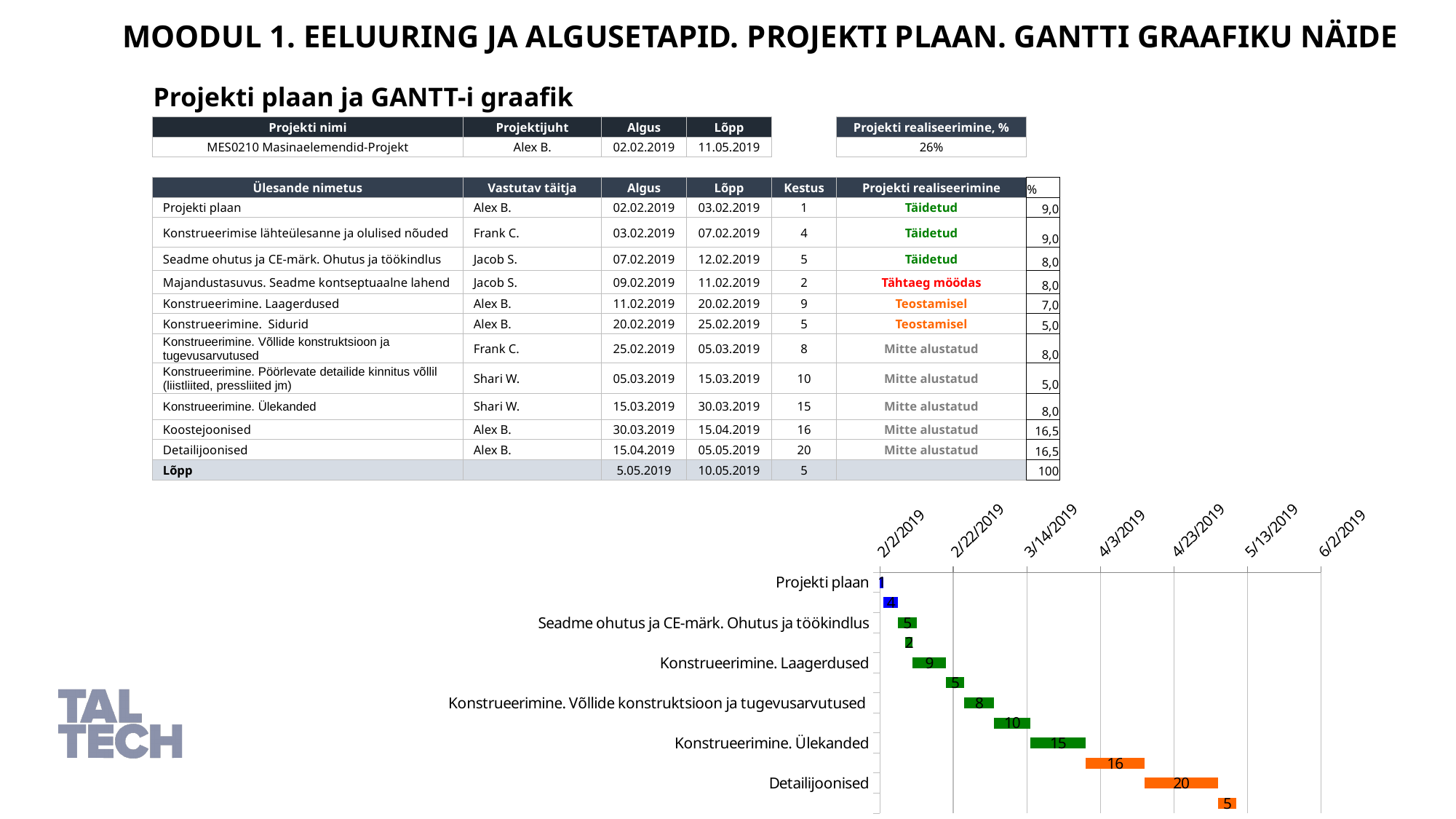
In the Gantt chart, what is the value labelled on the bar for Seadme ohutus ja CE-märk. Ohutus ja töökindlus? 5 In the Gantt chart, which labelled task has the shortest bar? Projekti plaan In the Gantt chart, which labelled task has the longest bar? Detailijoonised How many bars are plotted in the Gantt chart? 12 In the Gantt chart, what is the value labelled on the bar for Konstrueerimine. Võllide konstruktsioon ja tugevusarvutused? 8 In the Gantt chart, what is the difference between the values for Detailijoonised and Konstrueerimine. Ülekanded? 5 In the Gantt chart, what is the value labelled on the bar for Konstrueerimine. Ülekanded? 15 In the Gantt chart, what is the value labelled on the bar for Detailijoonised? 20 In the Gantt chart, which has the larger value: Konstrueerimine. Laagerdused or Konstrueerimine. Võllide konstruktsioon ja tugevusarvutused? Konstrueerimine. Laagerdused What type of chart is shown at the bottom of the slide? bar chart In the Gantt chart, what is the value labelled on the bar for Konstrueerimine. Laagerdused? 9 In the Gantt chart, what is the value labelled on the bar for Projekti plaan? 1